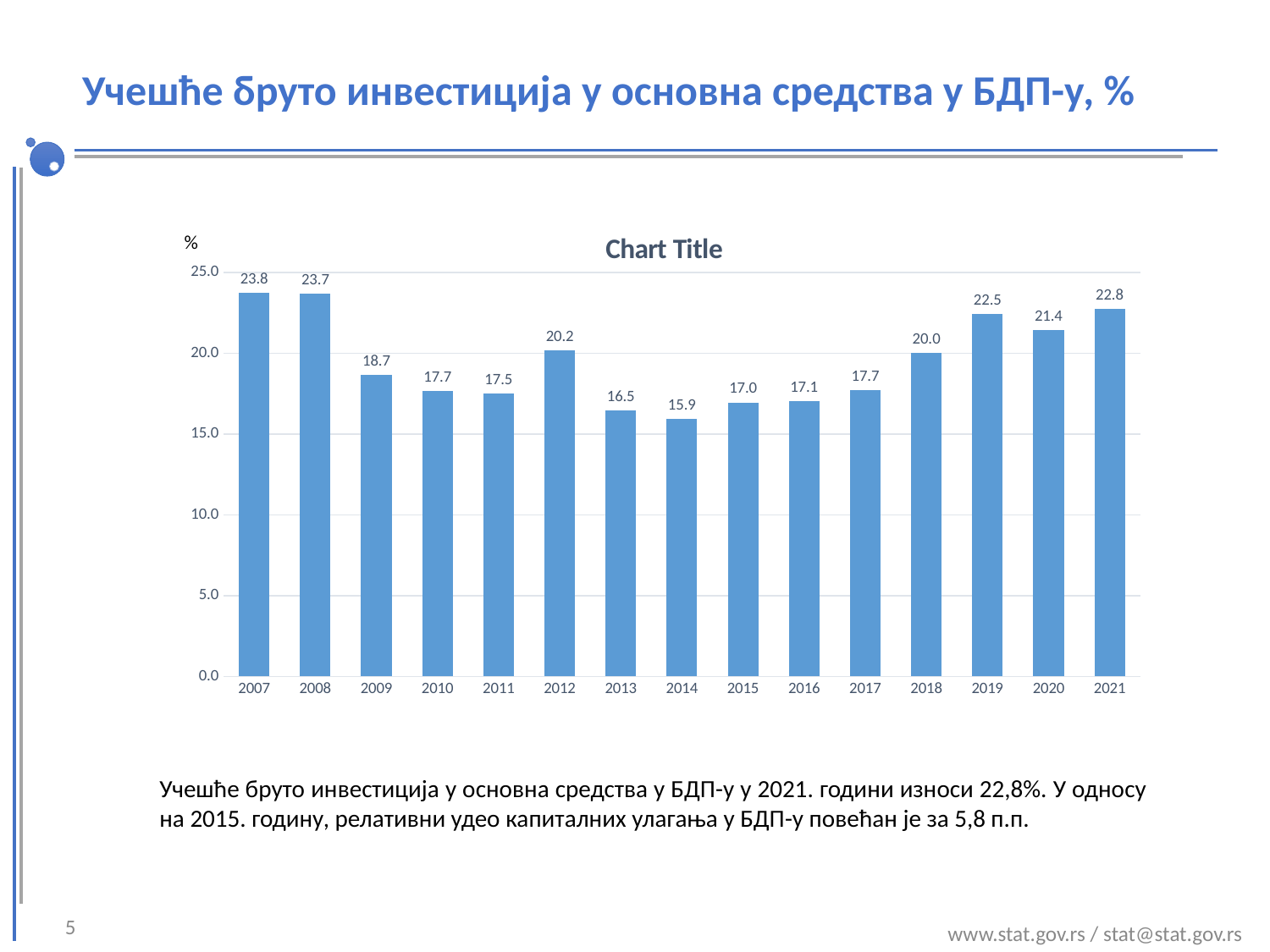
What is the value for 2014? 15.9 What is the value for 2012? 20.2 What is the difference between the values for 2021 and 2015? 5.8 What is the difference between the values for 2007 and 2014? 7.9 What is the value for 2018? 20.0 Which is larger, the value for 2009 or the value for 2013? 2009 Which year has the lowest value? 2014 Do the values rise or fall from 2014 to 2019? rise What is the value for 2021? 22.8 What type of chart is shown on the slide? bar chart What is the title shown above the chart? Chart Title How many years are shown on the x axis? 15